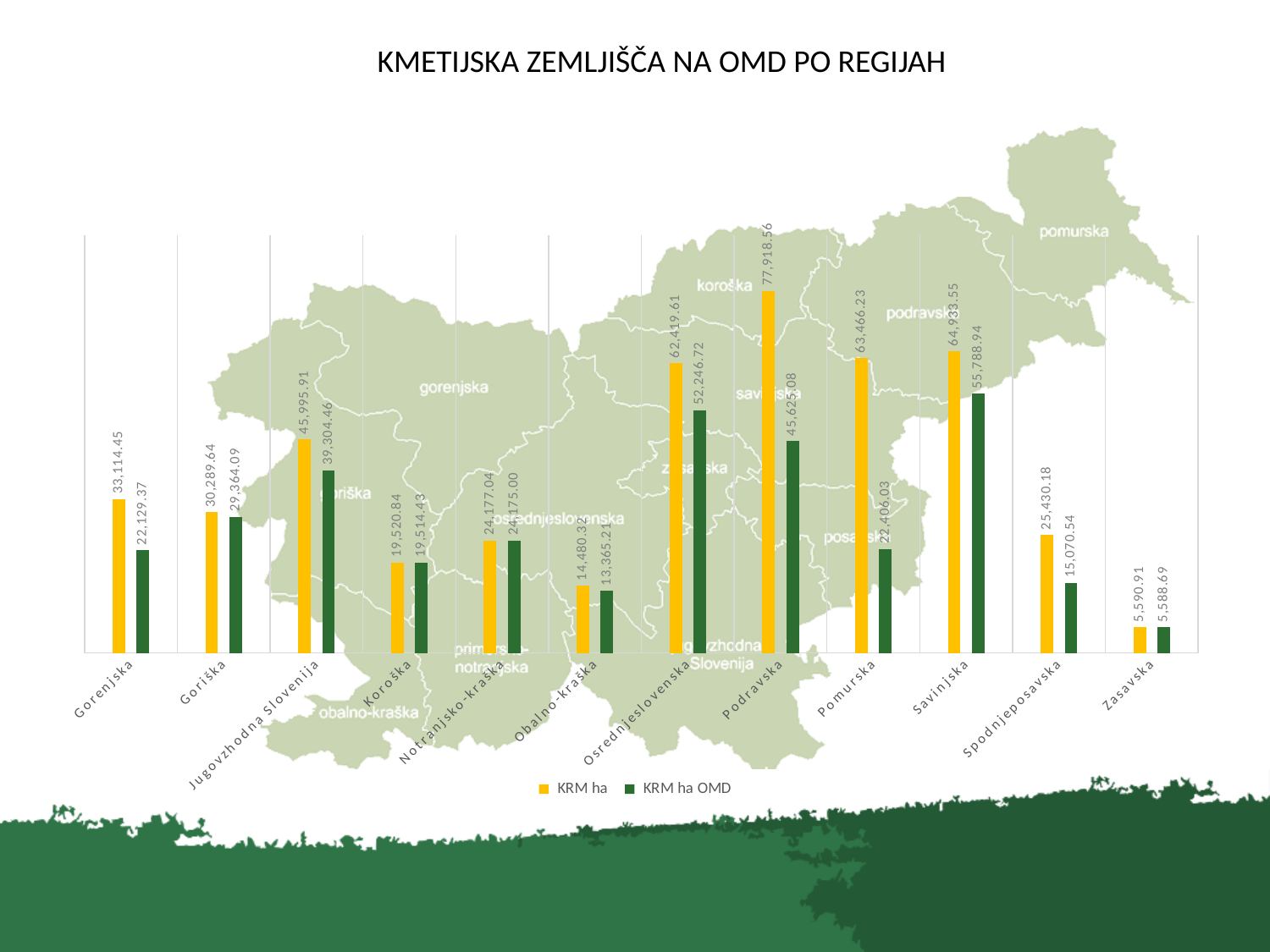
What is the KRM ha value for Podravska? 77,918.56 What is the KRM ha OMD value for Spodnjeposavska? 15,070.54 What is the KRM ha OMD value for Savinjska? 55,788.94 Which is larger: the KRM ha OMD value for Osrednjeslovenska or for Podravska? Osrednjeslovenska What type of chart is shown on the slide? Bar chart How many series does the legend list? 2 What is the difference between the KRM ha and KRM ha OMD values for Podravska? 32,293.48 Which region has the highest KRM ha value? Podravska How many regions are shown on the x axis? 12 Which region has the highest KRM ha OMD value? Savinjska What is the KRM ha value for Gorenjska? 33,114.45 Which region has the lowest KRM ha OMD value? Zasavska